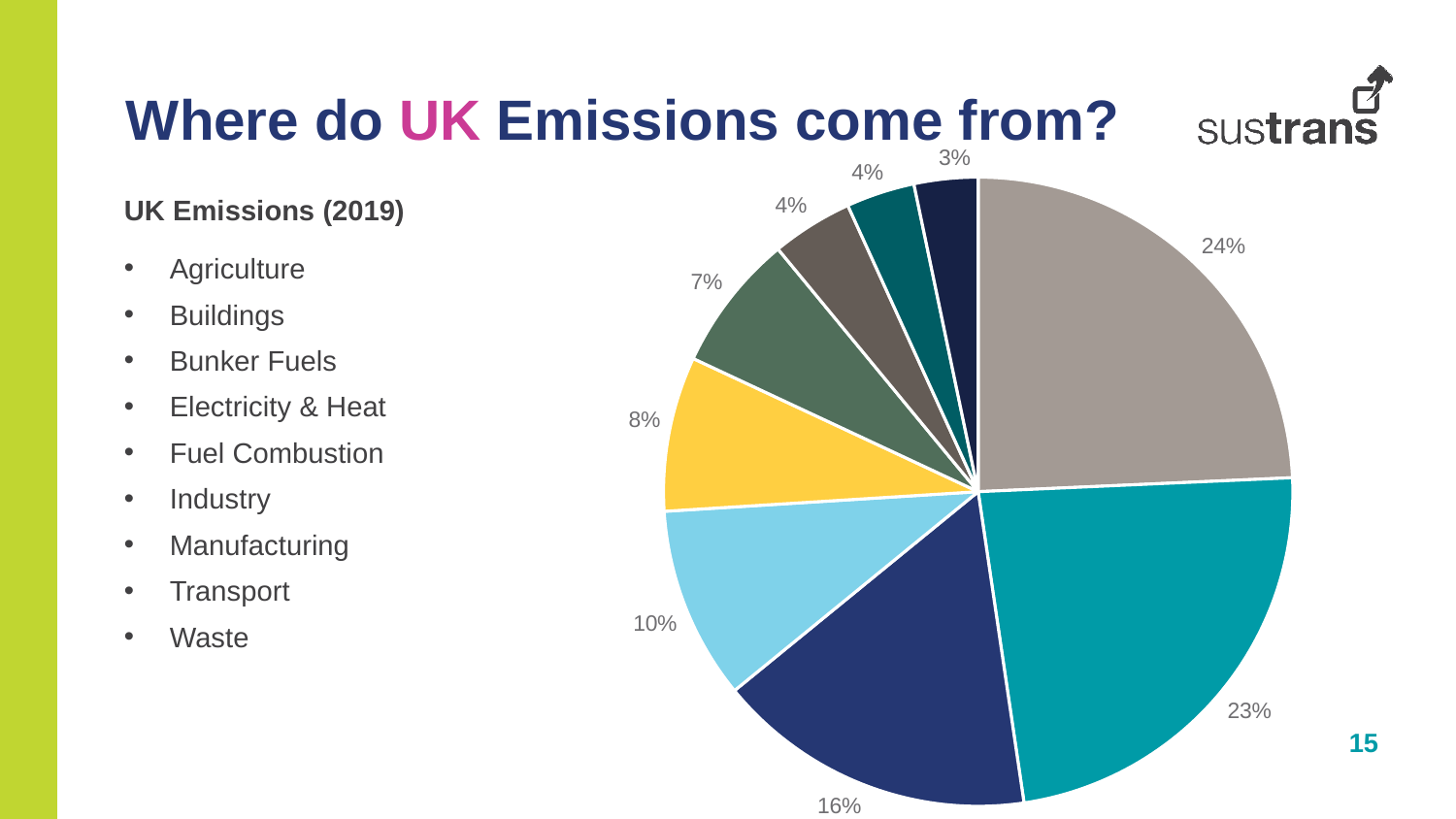
What is the value of the largest slice in the pie chart? 24% What is the difference between the 16% slice and the 10% slice? 6 percentage points Which slice is larger: the 16% slice or the 10% slice? The 16% slice What percentage is shown for the yellow slice of the pie chart? 8% How many slices does the pie chart have? 9 Which year do the UK emissions shown on the slide refer to? 2019 What percentage is shown for the light blue slice of the pie chart? 10% How many slices in the pie chart are labelled 4%? 2 What kind of chart is shown on the slide? Pie chart What percentage is shown for the large grey slice at the top right of the pie chart? 24% What is the difference between the two largest slices of the pie chart (24% and 23%)? 1 percentage point What is the value of the smallest slice in the pie chart? 3%